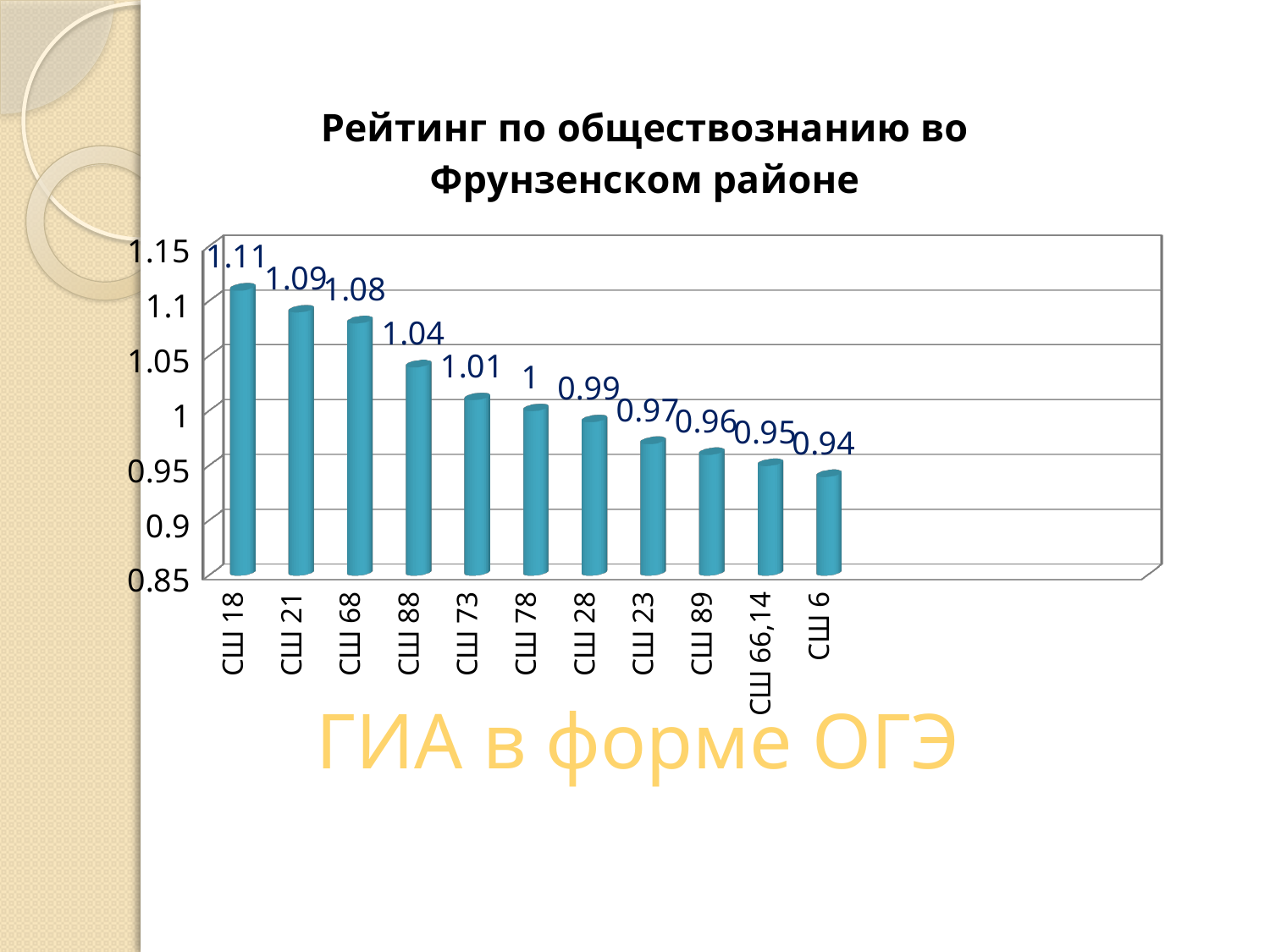
Is the value for СШ 23 greater or less than 1? less How many categories are shown on the chart? 11 What is the value for СШ 66,14? 0.95 Do the values rise or fall from left to right along the x axis? fall What is the value for СШ 88? 1.04 What is the difference between the values for СШ 18 and СШ 6? 0.17 What kind of chart is shown on the slide? bar chart What is the title of the chart? Рейтинг по обществознанию во Фрунзенском районе Which is larger, the value for СШ 68 or the value for СШ 73? СШ 68 Which category has the lowest value? СШ 6 What is the value for СШ 18? 1.11 Which category has the highest value? СШ 18